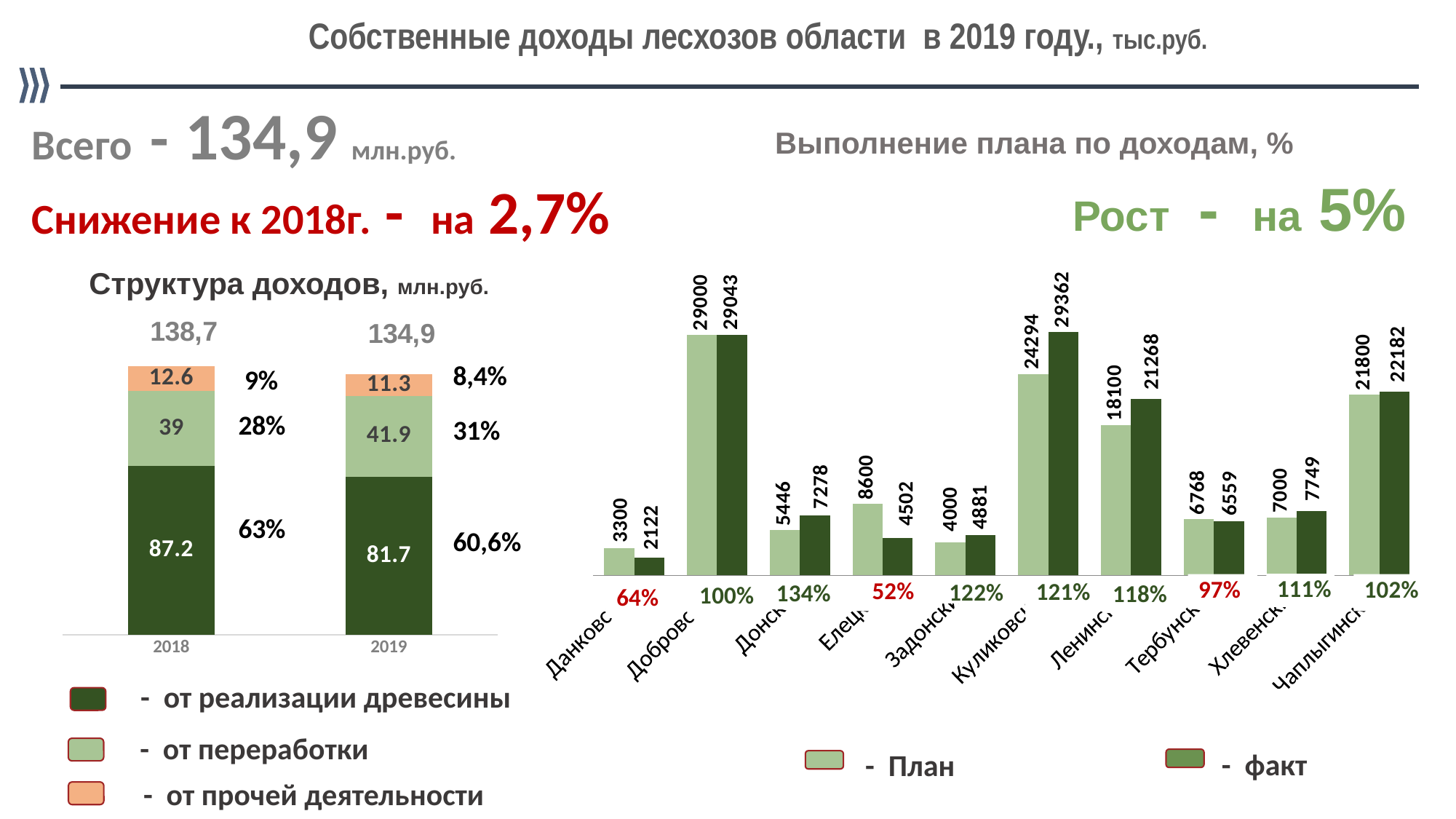
On the chart 'Структура доходов, млн.руб.', what is the value for 'от реализации древесины' in 2019? 81.7 On the chart 'Выполнение плана по доходам, %', which is larger for Елецк: 'План' or 'факт'? План On the chart 'Структура доходов, млн.руб.', what is the value for 'от переработки' in 2018? 39 On the chart 'Выполнение плана по доходам, %', which district has the lowest 'факт' value? Данковс On the chart 'Структура доходов, млн.руб.', what is the total of the 2018 stacked bar? 138,7 On the chart 'Выполнение плана по доходам, %', what is the difference between 'факт' and 'План' for Ленинс? 3168 On the chart 'Выполнение плана по доходам, %', what is the 'План' value for Добровс? 29000 On the chart 'Структура доходов, млн.руб.', by how much did 'от прочей деятельности' change from 2018 (12.6) to 2019 (11.3)? 1.3 On the chart 'Структура доходов, млн.руб.', how many series does the legend list? 3 On the chart 'Выполнение плана по доходам, %', which district has the highest 'План' value? Добровс On the chart 'Выполнение плана по доходам, %', what is the 'факт' value for Куликовс? 29362 On the chart 'Выполнение плана по доходам, %', how many districts are shown on the x axis? 10